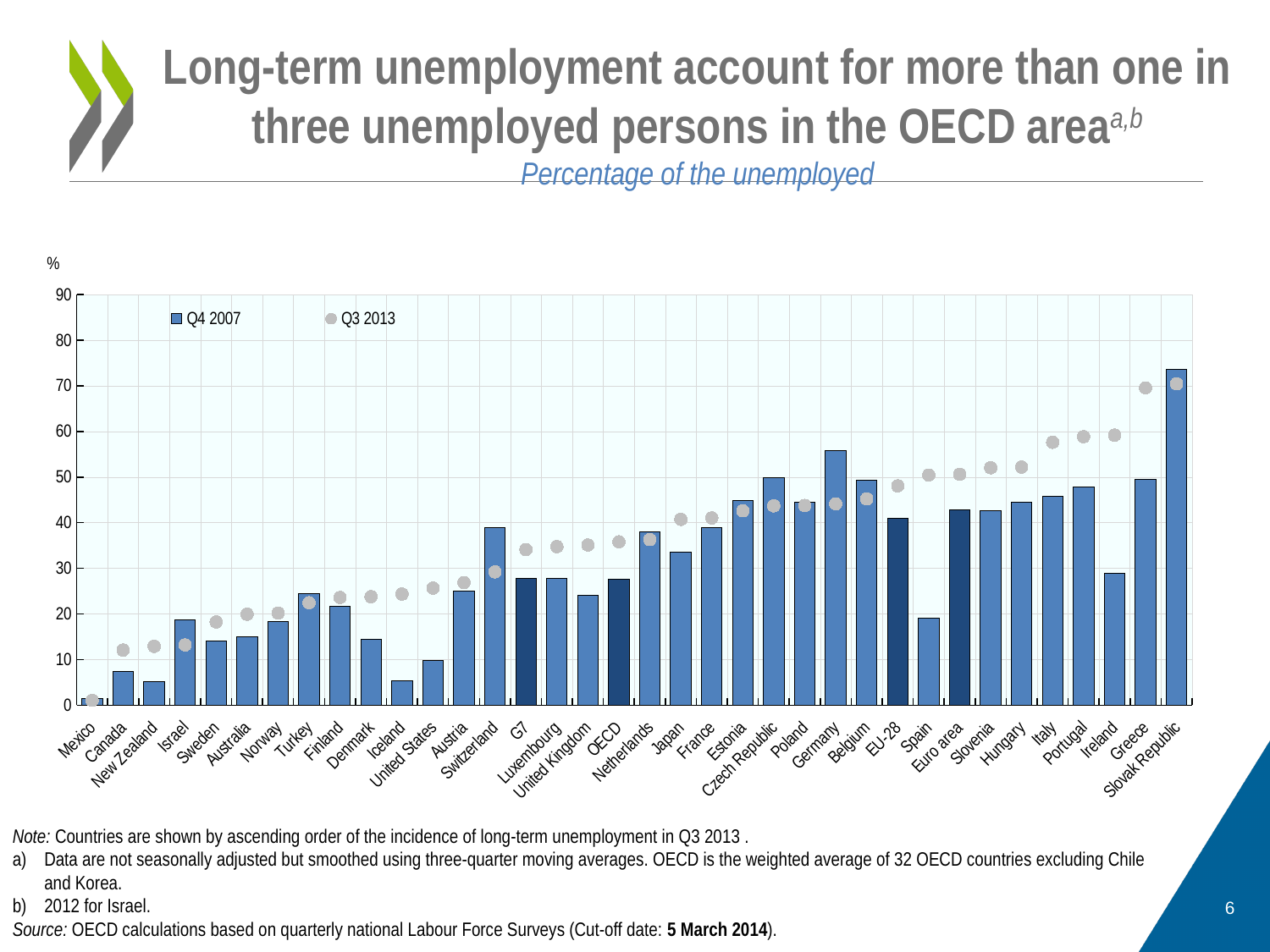
What are the two series named in the legend? Q4 2007 and Q3 2013 For Ireland, which is larger: the Q4 2007 value or the Q3 2013 value? Q3 2013 Which country has the lowest Q4 2007 value? Mexico Is the Q4 2007 value for Germany greater or less than 50? greater How many series does the legend list? 2 Which country has the lowest Q3 2013 value? Mexico Do the Q3 2013 values rise or fall moving from left to right along the x axis? rise Which country has the highest Q4 2007 value? Slovak Republic Is the Q3 2013 value for Ireland greater or less than 50? greater How many countries or areas are shown along the x axis? 36 What kind of chart is shown on the slide? bar chart